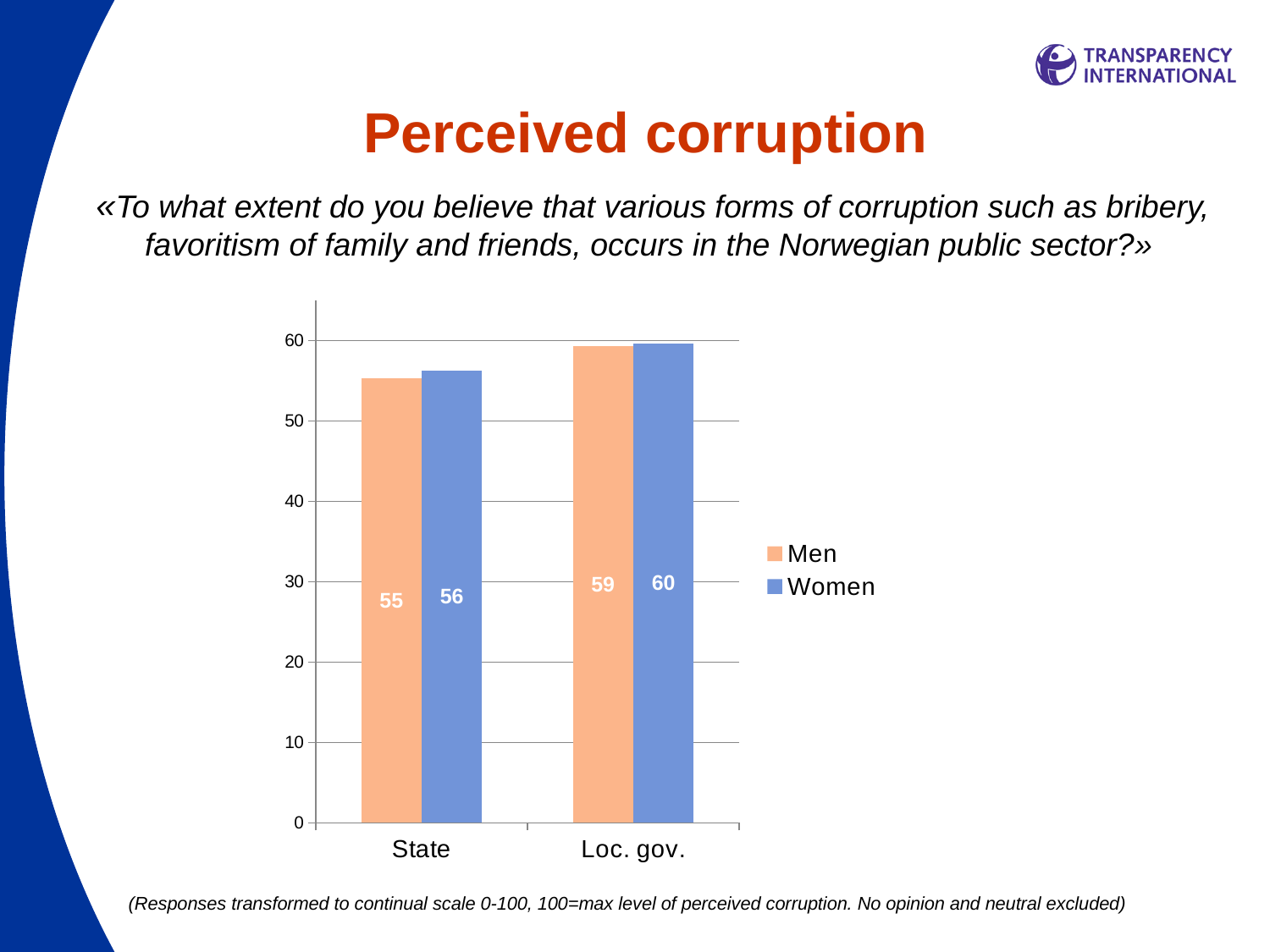
Which category has the highest value for Women? Loc. gov. What is the value for Women in the Loc. gov. category? 60 What is the value for Men in the State category? 55 What kind of chart is shown on the slide? bar chart Is the value for Men in the State category greater or less than 50? greater What is the value for Men in the Loc. gov. category? 59 What is the difference between the Women and Men values for Loc. gov.? 1 What is the difference between the Men values for Loc. gov. and State? 4 How many series does the legend list? 2 Which category has the lowest value for Men? State How many categories are shown on the x axis? 2 What is the value for Women in the State category? 56